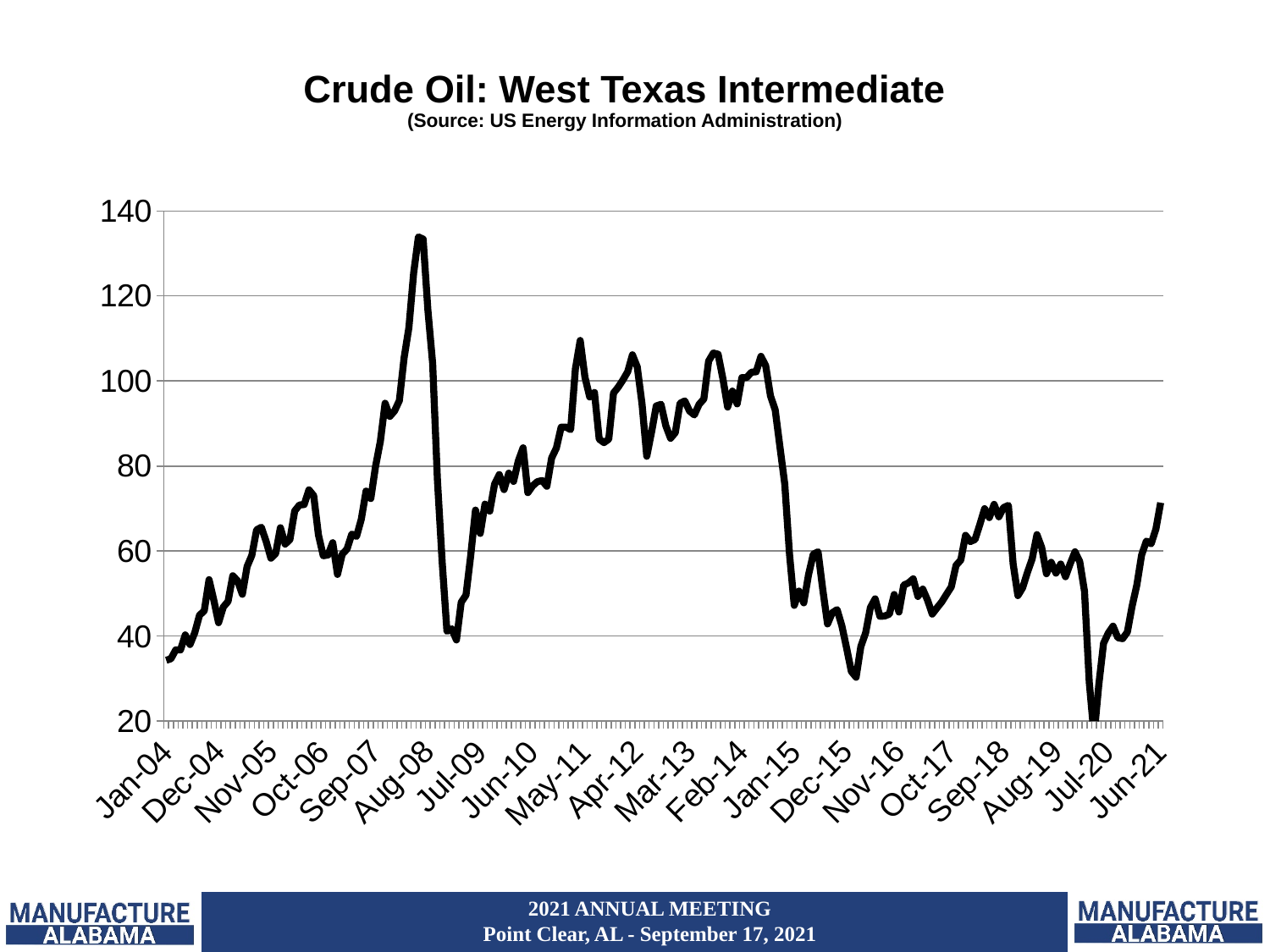
Is the value for Jan-04 greater or less than 40? less Which is larger, the value for Jun-10 or the value for Dec-15? Jun-10 Is the value for Aug-08 greater or less than 100? greater Is the value for Jun-21 greater or less than 60? greater Does the line rise or fall between Feb-14 and Jan-15? fall What kind of chart is shown on the slide? Line chart What is the title of the chart? Crude Oil: West Texas Intermediate Does the line rise or fall between Jan-04 and Aug-08? rise What source is cited for the chart's data? US Energy Information Administration